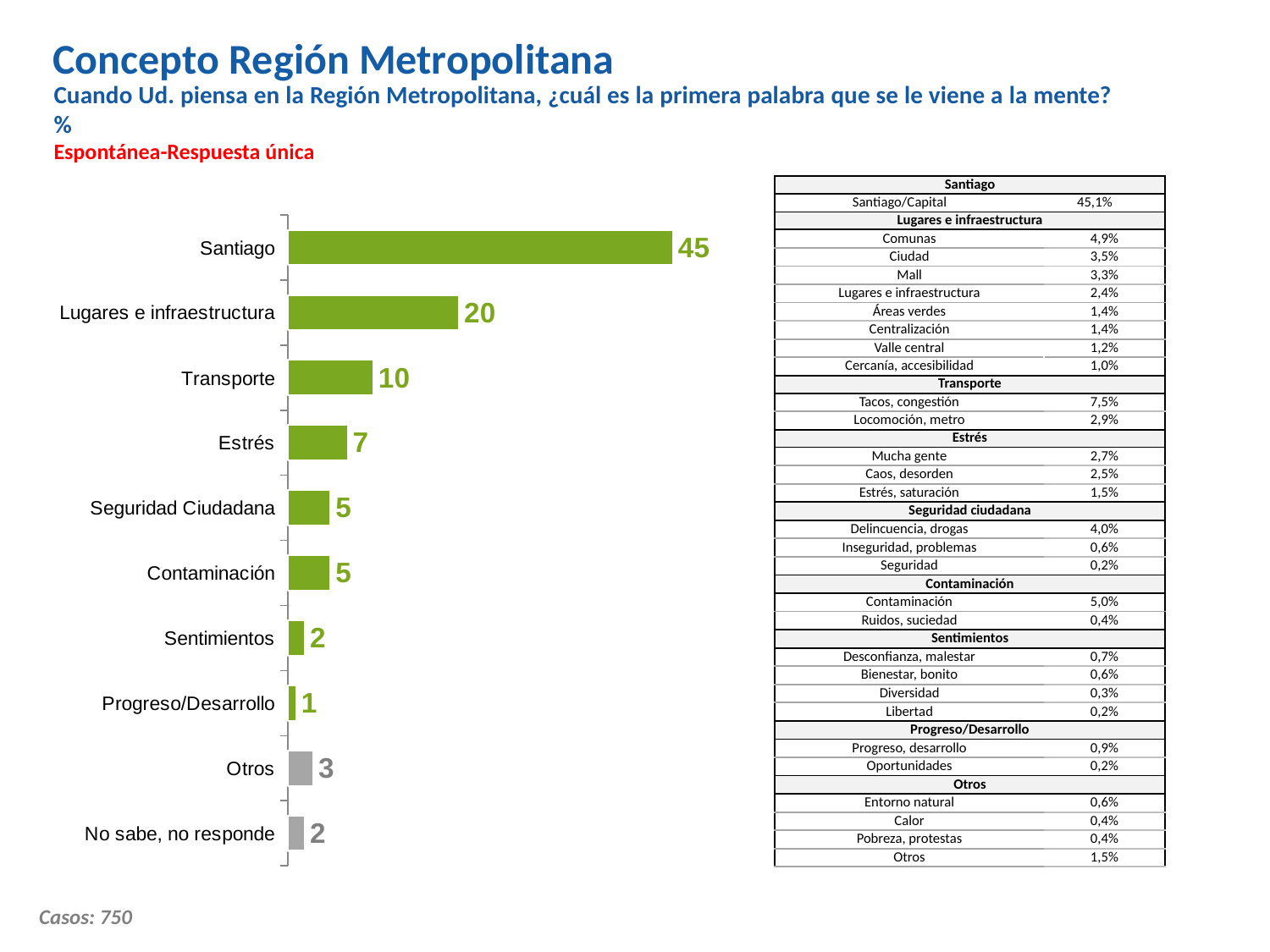
What is the difference between the values for Santiago and Lugares e infraestructura? 25 What is the value for Santiago in the bar chart? 45 Which two categories in the bar chart are drawn in grey rather than green? Otros and No sabe, no responde What is the difference between the values for Transporte and Estrés? 3 Which is larger, the value for Otros or the value for Sentimientos? Otros Which category has the lowest value in the bar chart? Progreso/Desarrollo Which is larger, the value for Estrés or the value for Seguridad Ciudadana? Estrés What is the value for Transporte in the bar chart? 10 What is the value for Lugares e infraestructura in the bar chart? 20 How many categories are shown in the bar chart? 10 Which category has the highest value in the bar chart? Santiago What kind of chart is shown on the slide? bar chart